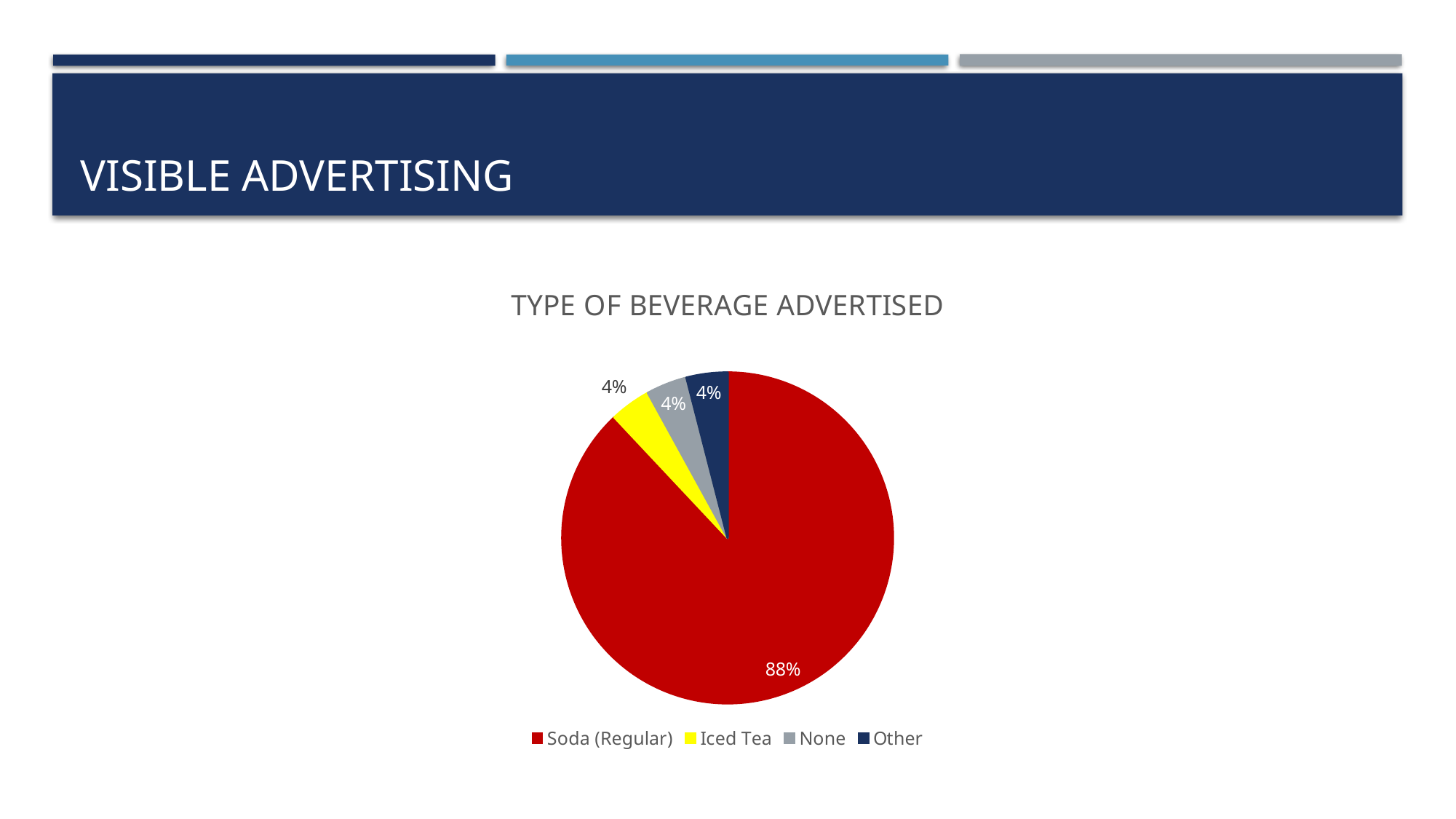
How many categories does the legend list? 4 What is the difference between the Soda (Regular) share and the Iced Tea share? 84% Which is larger, the share for Soda (Regular) or the share for Other? Soda (Regular) What percentage of the pie is None? 4% Which category has the largest share of the pie? Soda (Regular) What percentage of the pie is Iced Tea? 4% What percentage of the pie is Soda (Regular)? 88% What type of chart is shown on the slide? Pie chart What is the combined share of Iced Tea, None and Other? 12% What percentage of the pie is Other? 4% What is the title of the chart? TYPE OF BEVERAGE ADVERTISED What colour is the Iced Tea slice? Yellow